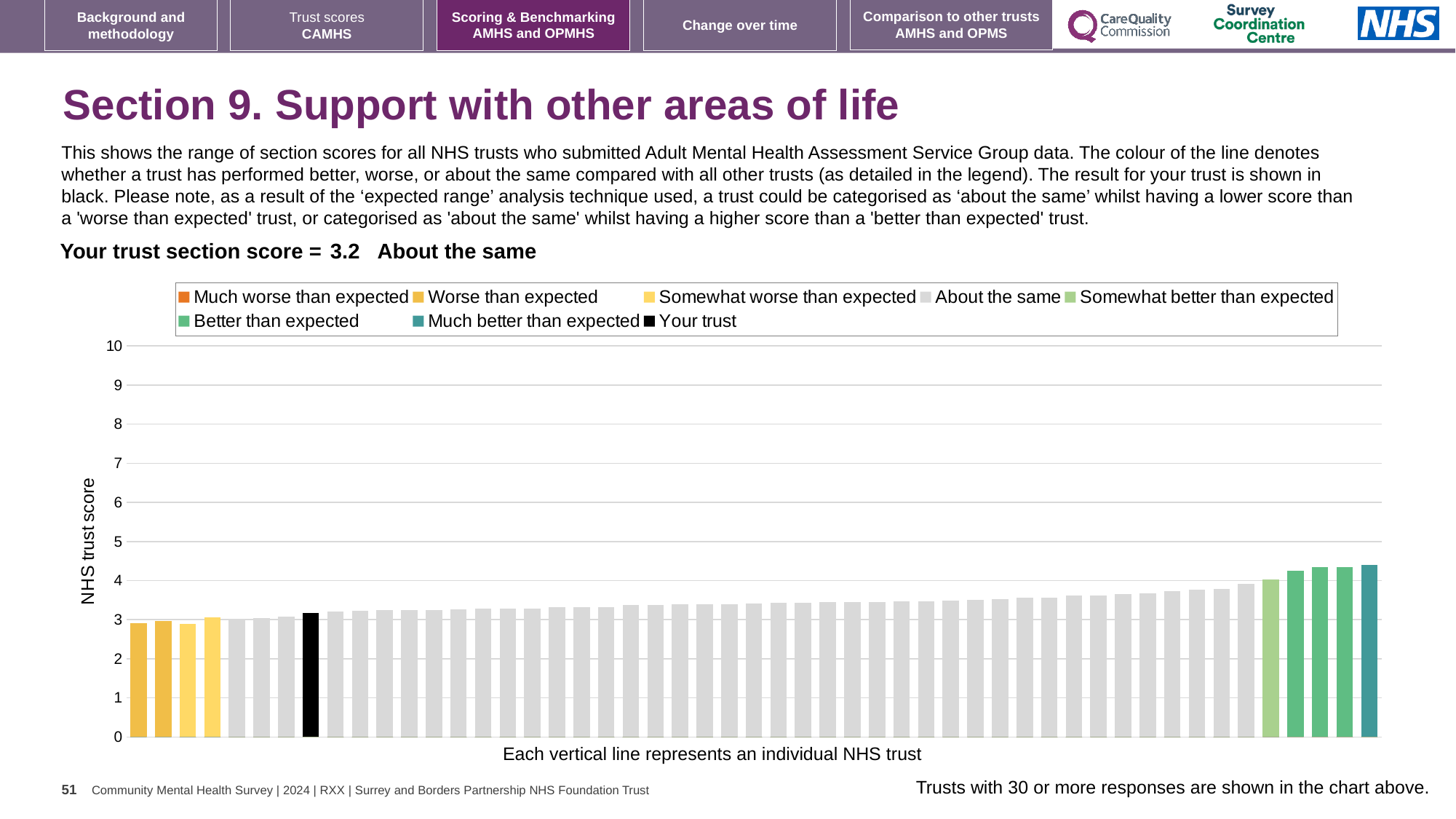
Is the tallest bar in the chart greater or less than 5? less Is the value for your trust greater or less than 3? greater Is the tallest bar in the chart greater or less than 4? greater What is the section score for your trust? 3.2 What kind of chart is shown on the slide? bar chart What colour is used for 'Your trust' in the chart? black How many entries does the chart legend list? 8 What is the label on the y axis of the chart? NHS trust score Which is larger: the bar for your trust or the leftmost bar? your trust How many bars are coloured as 'Much better than expected'? 1 How many bars are coloured as 'Better than expected'? 3 Do the bar values rise or fall from left to right along the x axis? rise